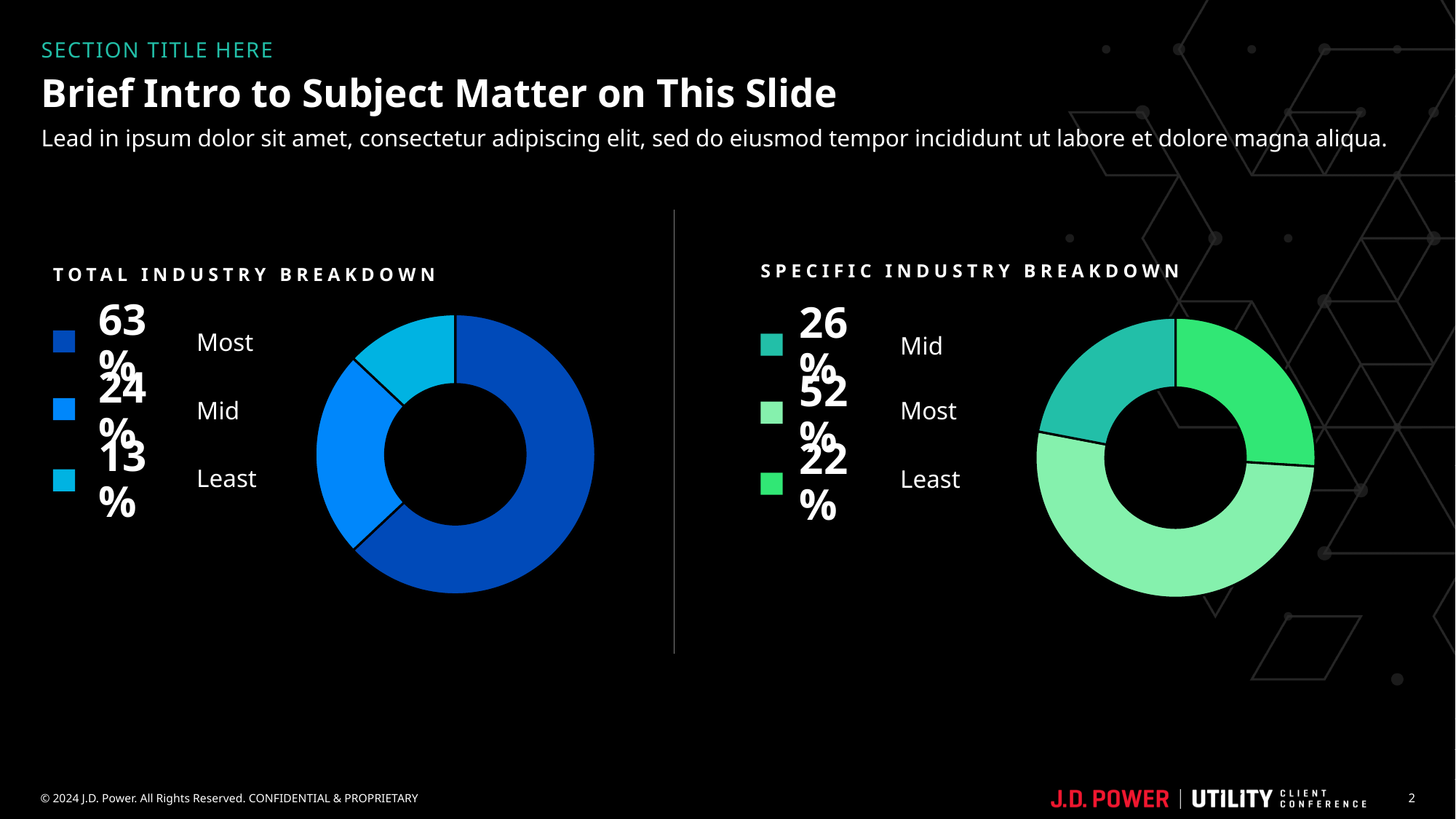
In the Total Industry Breakdown chart, what is the value for Most? 63% In the Specific Industry Breakdown chart, what is the difference between Most and Least? 30% In the Total Industry Breakdown chart, what is the difference between Most and Mid? 39% In the Total Industry Breakdown chart, which category has the largest share? Most In the Total Industry Breakdown chart, what is the value for Least? 13% What is the title of the chart on the left side of the slide? Total Industry Breakdown In the Specific Industry Breakdown chart, what is the value for Mid? 26% Which is larger: Mid in the Total Industry Breakdown chart or Mid in the Specific Industry Breakdown chart? Mid in the Specific Industry Breakdown chart In the Specific Industry Breakdown chart, which category has the smallest share? Least What kind of chart is the Specific Industry Breakdown chart? Donut chart How many categories does the Total Industry Breakdown chart show? 3 In the Specific Industry Breakdown chart, what is the value for Most? 52%